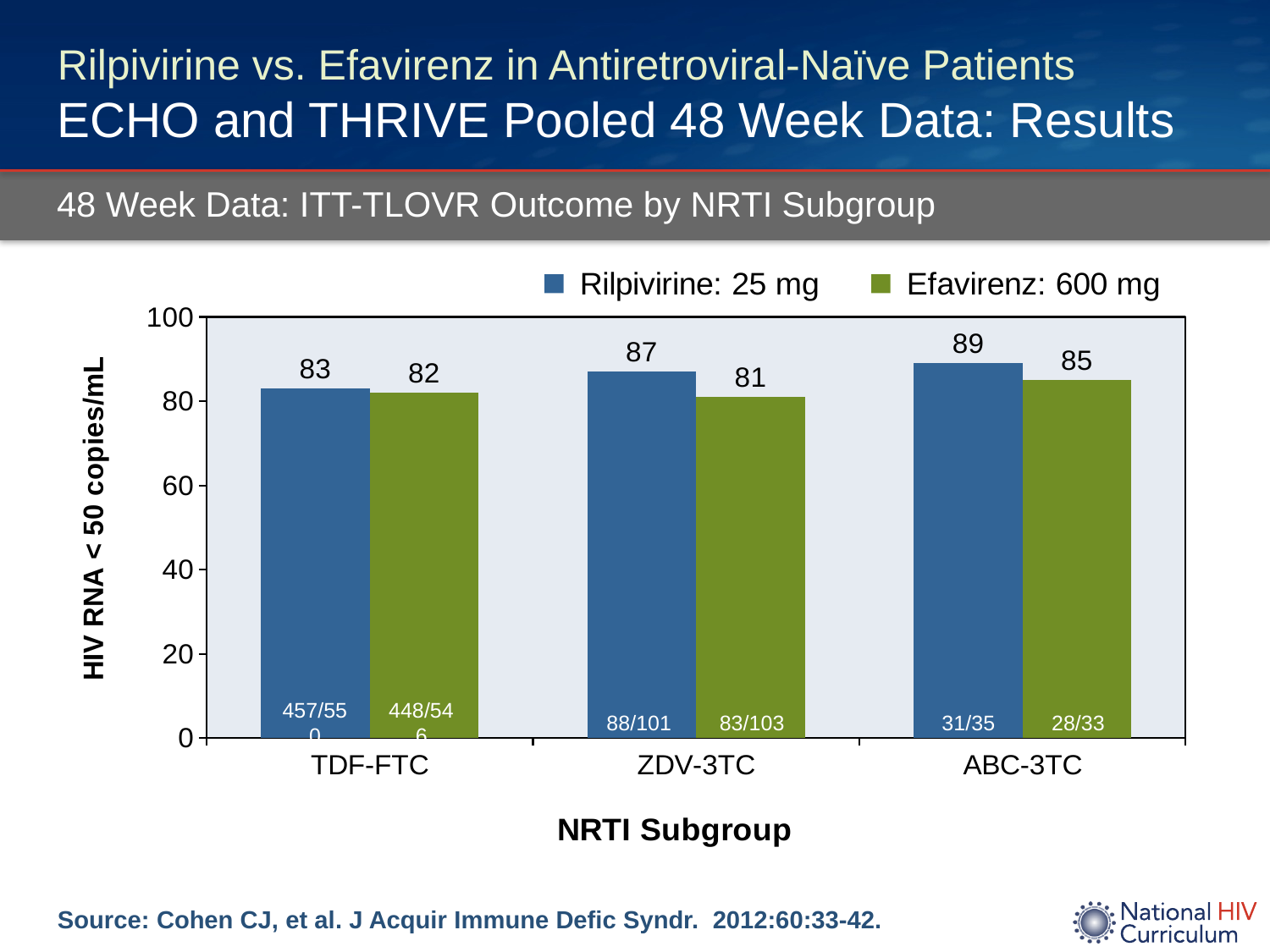
What is the difference between the Rilpivirine: 25 mg and Efavirenz: 600 mg values in the ZDV-3TC subgroup? 6 How many NRTI subgroups are shown on the x axis? 3 What kind of chart is shown on the slide? Bar chart What is the label of the y axis? HIV RNA < 50 copies/mL Which NRTI subgroup has the lowest value for Efavirenz: 600 mg? ZDV-3TC In the ABC-3TC subgroup, which is larger: the Rilpivirine: 25 mg value or the Efavirenz: 600 mg value? Rilpivirine: 25 mg What is the value for Efavirenz: 600 mg in the ZDV-3TC subgroup? 81 What is the value for Rilpivirine: 25 mg in the TDF-FTC subgroup? 83 Which NRTI subgroup has the highest value for Rilpivirine: 25 mg? ABC-3TC What is the value for Efavirenz: 600 mg in the ABC-3TC subgroup? 85 How many series does the legend list? 2 What is the value for Rilpivirine: 25 mg in the ABC-3TC subgroup? 89